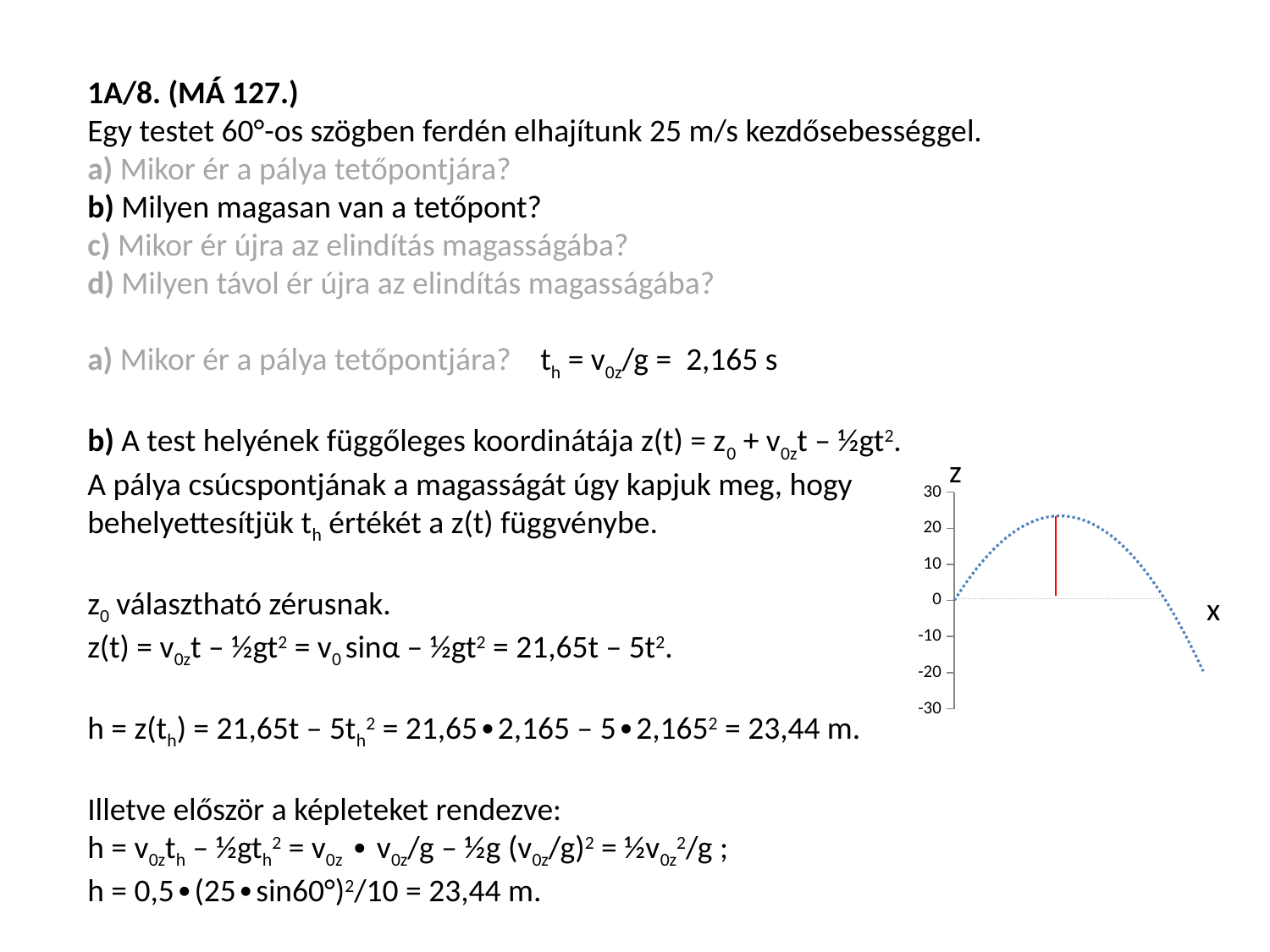
Is the peak value of the dotted curve greater or less than 20? greater Is the value of the dotted curve at its right end greater or less than -10? less Is the value of the dotted curve at its right end greater or less than -30? greater What is the lowest tick value shown on the vertical axis of the chart? -30 How many tick labels are shown on the vertical axis of the chart? 7 What is the label of the horizontal axis of the chart? x What kind of chart is shown on the right side of the slide? line chart (dotted curve) What is the highest tick value shown on the vertical axis of the chart? 30 How does the dotted curve behave along the x axis? rises to a peak, then falls What is the label of the vertical axis of the chart? z